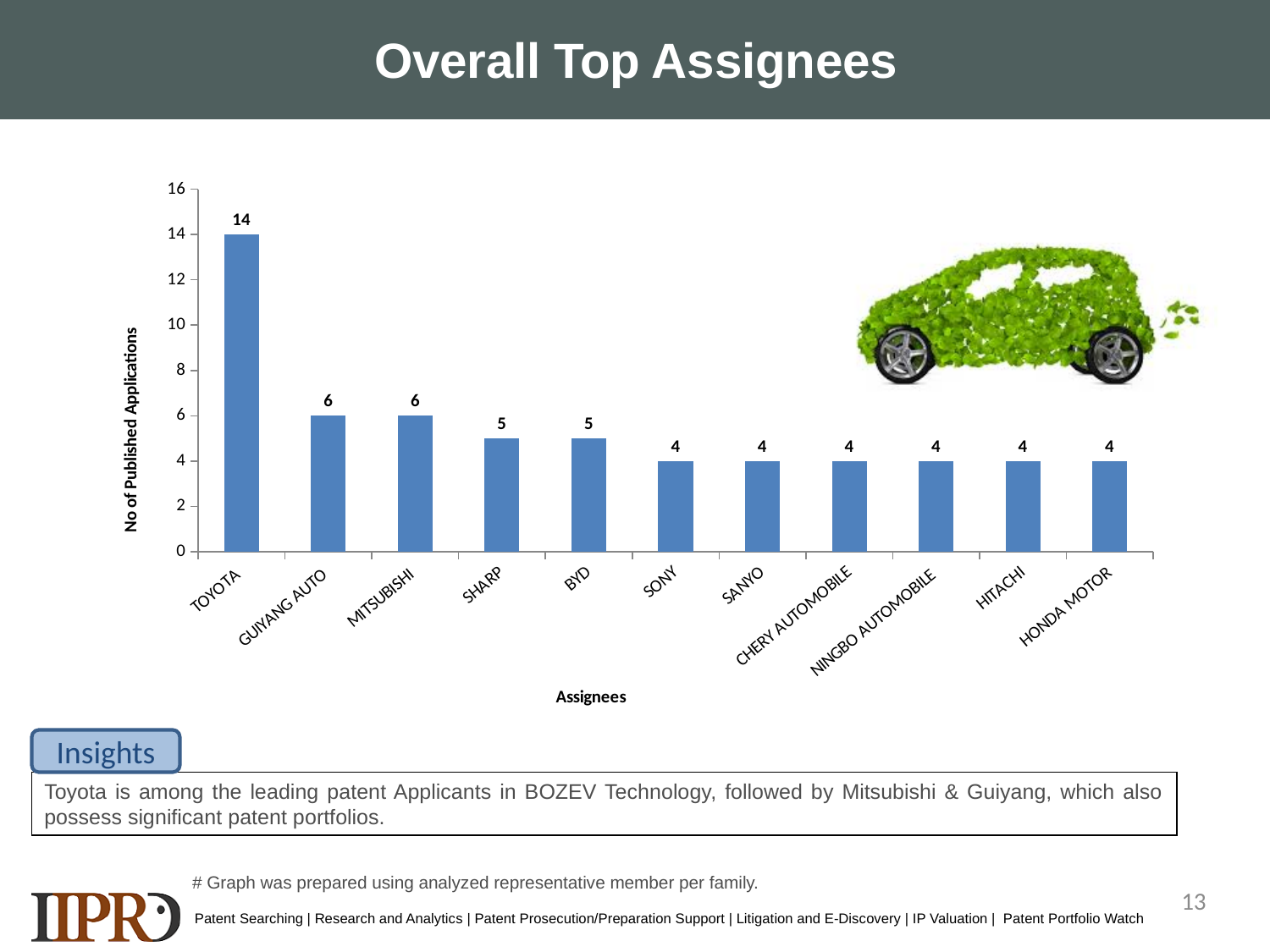
What is the value for SHARP? 5 What kind of chart is shown on the slide? Bar chart Which assignee has the highest number of published applications? TOYOTA What is the label of the horizontal axis? Assignees Is the value for TOYOTA greater or less than 10? greater What is the difference between the values for TOYOTA and GUIYANG AUTO? 8 Which is larger, the value for BYD or the value for HITACHI? BYD How many published applications does TOYOTA have? 14 What is the value for HONDA MOTOR? 4 How many assignees are shown on the chart? 11 What is the difference between the values for MITSUBISHI and SONY? 2 What is the label of the vertical axis? No of Published Applications